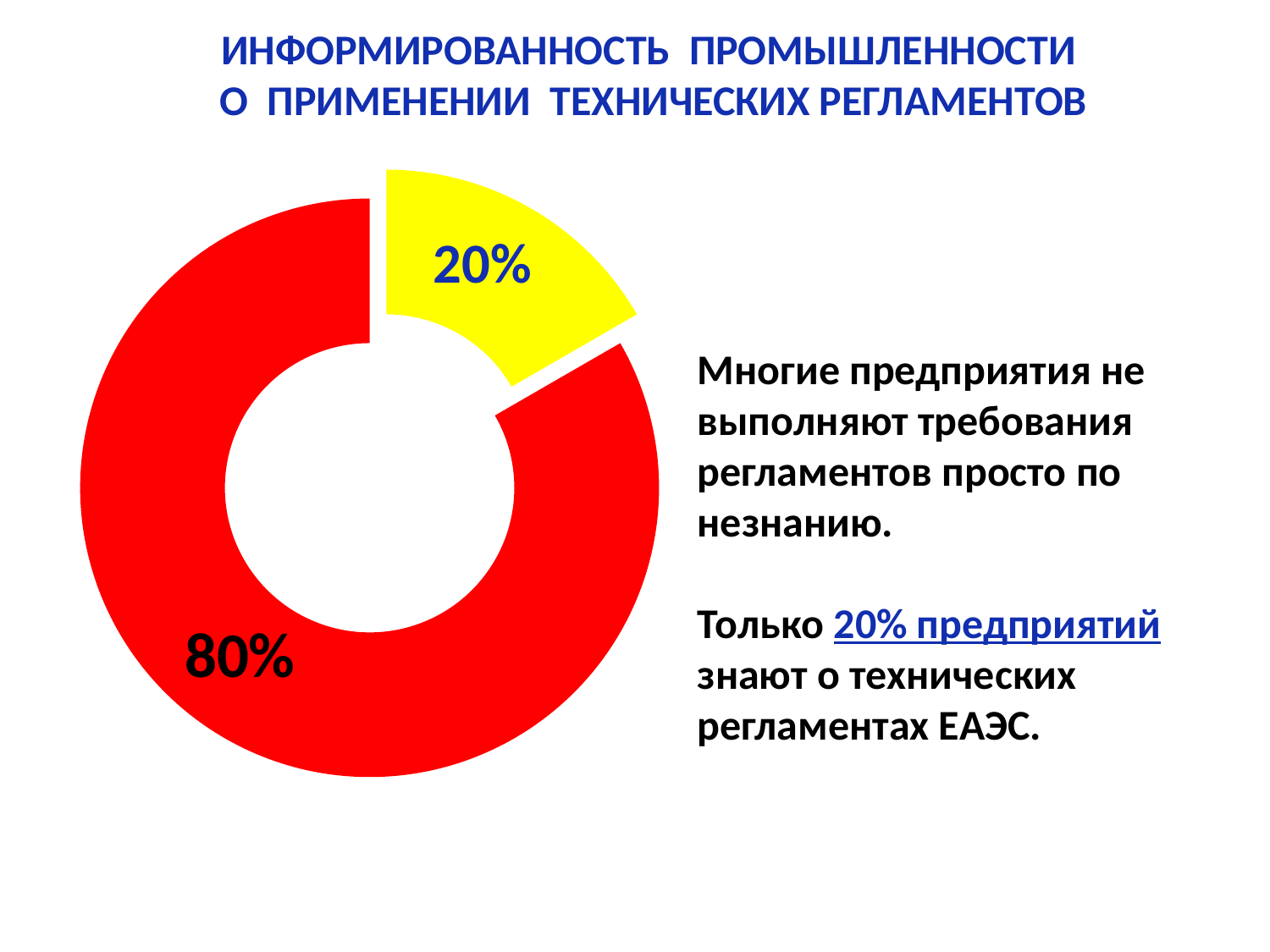
What share of the doughnut chart does the yellow slice represent? 20% What kind of chart is shown on the slide? doughnut chart According to the slide text, what percentage of enterprises know about the EAEU technical regulations? 20% Which is larger in the doughnut chart, the red slice or the yellow slice? the red slice Which slice of the doughnut chart is the smallest? the yellow slice (20%) What value is shown on the yellow slice of the doughnut chart? 20% What value is shown on the red slice of the doughnut chart? 80% What is the total of the two slices shown in the doughnut chart? 100% What colour is the slice labelled 80% in the doughnut chart? red Which slice of the doughnut chart is the largest? the red slice (80%) What is the difference between the red slice and the yellow slice in the doughnut chart? 60% How many slices does the doughnut chart have? 2